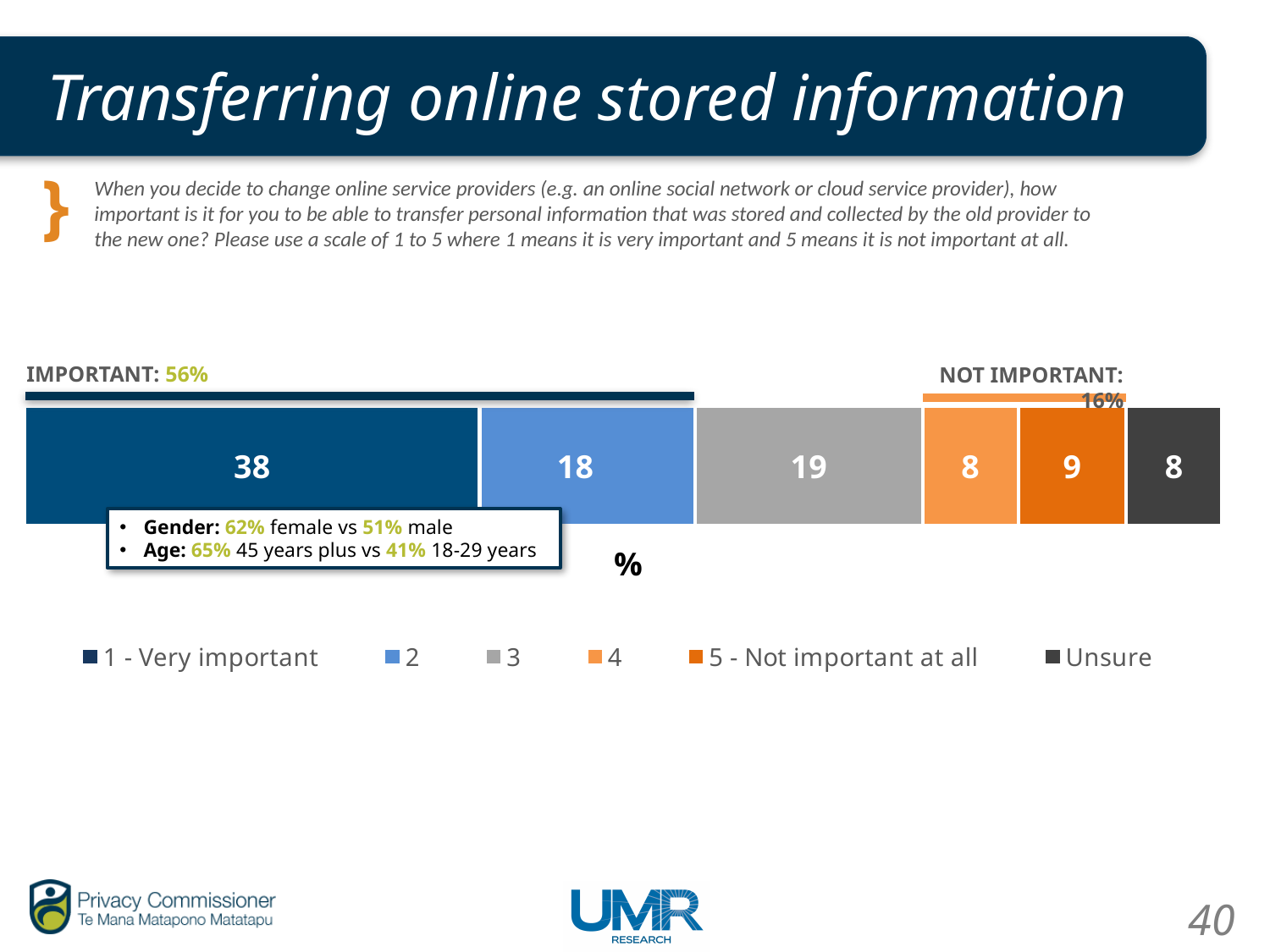
What value is shown for the 'Unsure' segment? 8 Which is larger, the '2' segment or the '3' segment? 3 What is the total of the '4' and '5 - Not important at all' segments combined? 17 What percentage is labelled as IMPORTANT above the bar? 56% What percentage is labelled as NOT IMPORTANT above the bar? 16% What percentage of respondents rated transferring online stored information as '1 - Very important'? 38 What is the difference between the '1 - Very important' segment and the '2' segment? 20 What kind of chart is shown on the slide? Stacked bar chart How many series does the legend list? 6 What is the total of the '1 - Very important' and '2' segments combined? 56 What value is shown for the '3' segment of the stacked bar? 19 Which legend category has the largest segment in the bar? 1 - Very important